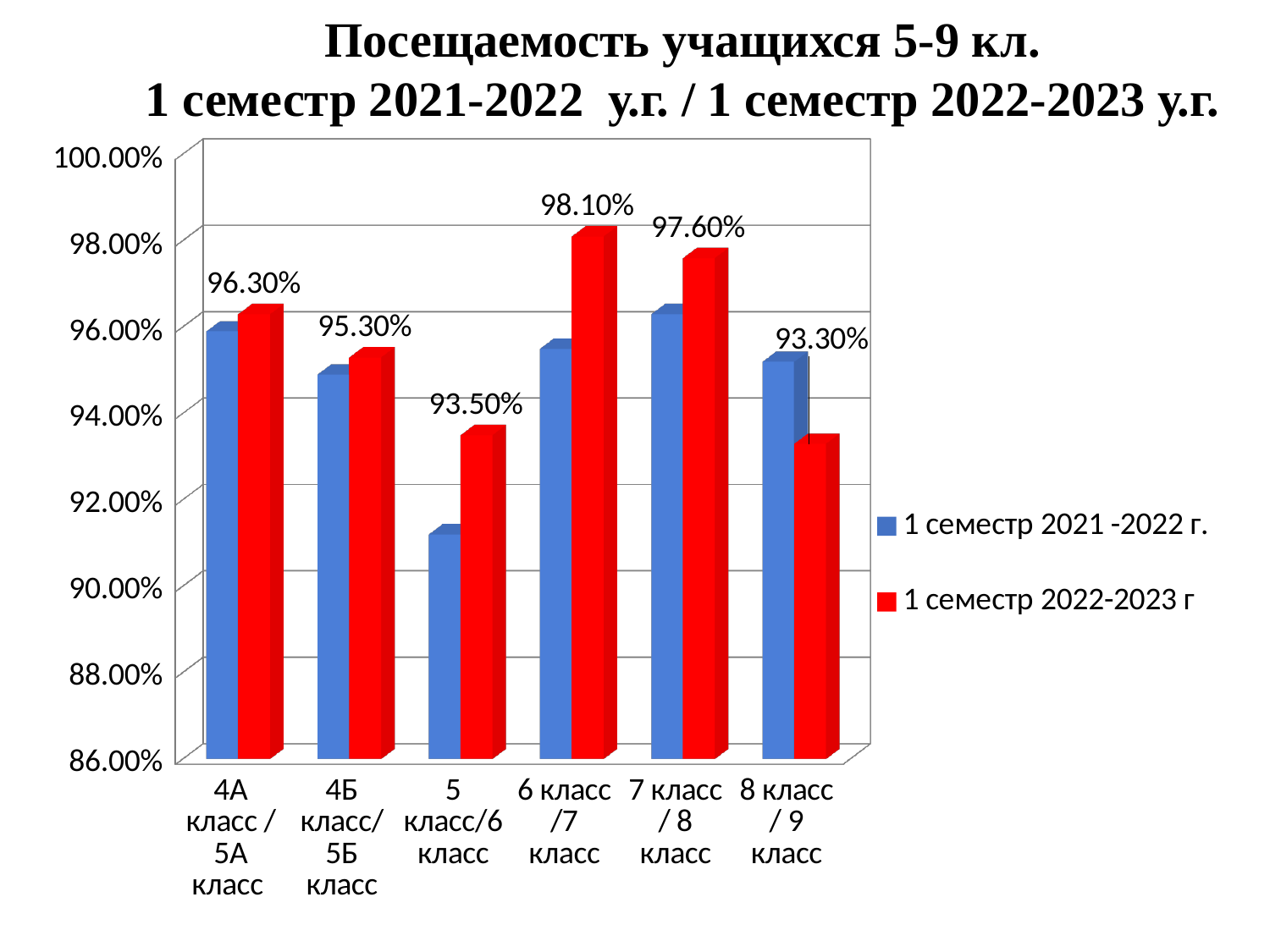
What is the value for "8 класс / 9 класс" in the "1 семестр 2022-2023 г" series? 93.30% For "8 класс / 9 класс", which series has the larger value: "1 семестр 2021 -2022 г." or "1 семестр 2022-2023 г"? 1 семестр 2021 -2022 г. Is the value for "7 класс / 8 класс" in the "1 семестр 2021 -2022 г." series greater or less than 94.00%? greater How many categories are shown on the x axis? 6 What is the difference between the highest and lowest values in the "1 семестр 2022-2023 г" series? 4.80% How many series does the legend list? 2 Which category has the highest value in the "1 семестр 2022-2023 г" series? 6 класс /7 класс Is the value for "5 класс/6 класс" in the "1 семестр 2021 -2022 г." series greater or less than 92.00%? less What is the value for "6 класс /7 класс" in the "1 семестр 2022-2023 г" series? 98.10% What is the value for "4Б класс/ 5Б класс" in the "1 семестр 2022-2023 г" series? 95.30% In the "1 семестр 2022-2023 г" series, which is larger: "6 класс /7 класс" or "7 класс / 8 класс"? 6 класс /7 класс Which category has the lowest value in the "1 семестр 2022-2023 г" series? 8 класс / 9 класс